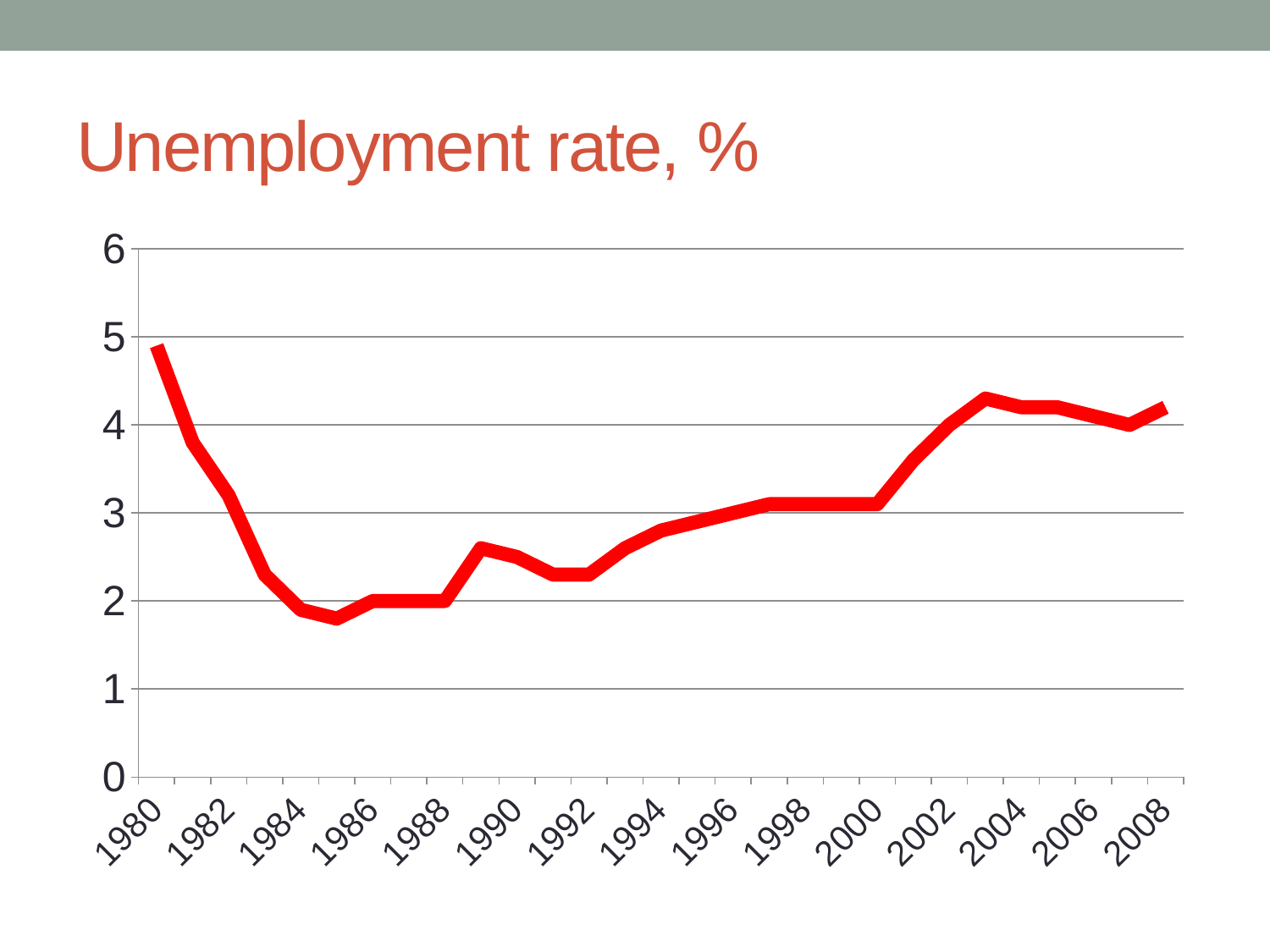
Is the value for 1980 greater or less than 4? greater In which year is the unemployment rate highest? 1980 Does the unemployment rate rise or fall between 1980 and 1985? fall What kind of chart is shown on the slide? line chart What is the title of the chart? Unemployment rate, % Is the value for 1985 greater or less than 2? less Does the unemployment rate rise or fall between 1992 and 2003? rise Which year has the larger unemployment rate, 1984 or 2004? 2004 Is the value for 2003 greater or less than 4? greater Which year has the larger unemployment rate, 1980 or 2008? 1980